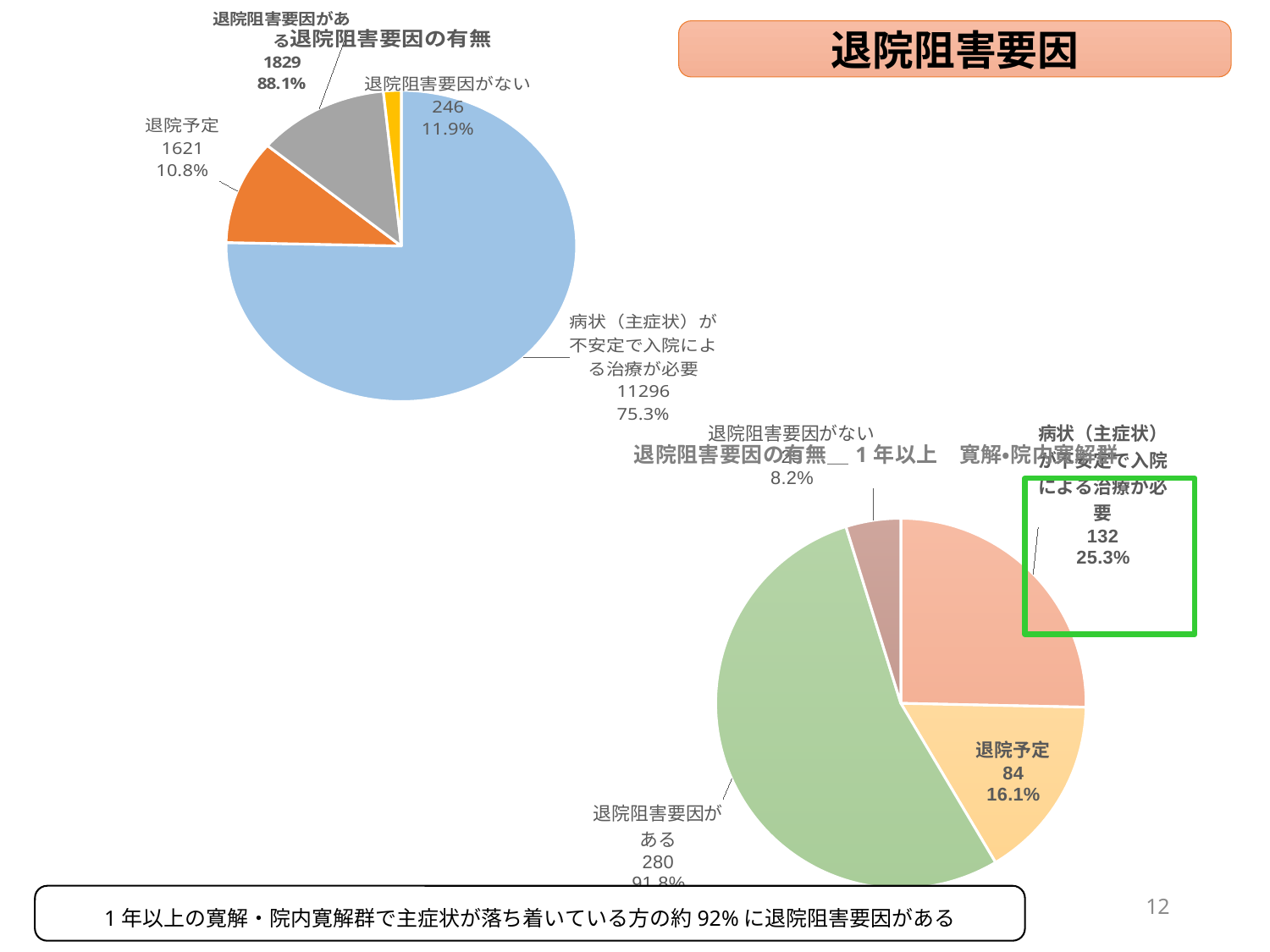
In the bottom-right pie chart, what value is shown for 病状（主症状）が不安定で入院による治療が必要? 132 In the top-left pie chart, what percentage is shown for 退院予定? 10.8% In the bottom-right pie chart, what percentage is shown for 病状（主症状）が不安定で入院による治療が必要? 25.3% In the bottom-right pie chart, what percentage is shown for 退院予定? 16.1% In the top-left pie chart, what value is shown for 退院予定? 1621 In the top-left pie chart, what value is shown for 病状（主症状）が不安定で入院による治療が必要? 11296 In the bottom-right pie chart, which is larger: the slice for 病状（主症状）が不安定で入院による治療が必要 or the slice for 退院予定? 病状（主症状）が不安定で入院による治療が必要 In the top-left pie chart, which slice is the largest? 病状（主症状）が不安定で入院による治療が必要 How many pie charts are shown on the slide? 2 What kind of chart is the top-left chart titled 退院阻害要因の有無? pie chart In the bottom-right pie chart, what value is shown for 退院予定? 84